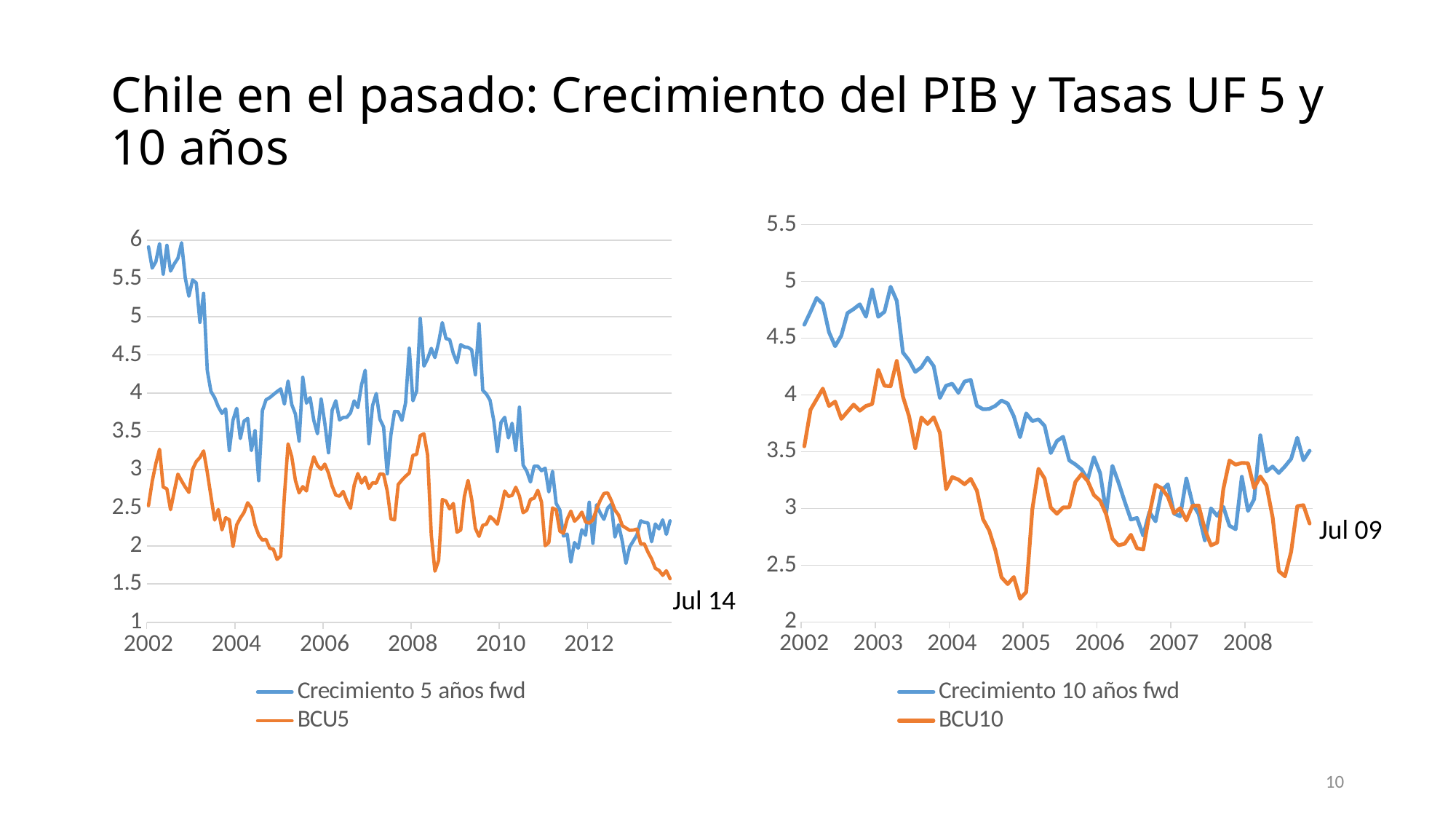
What kind of chart is the left chart on the slide? line chart In the right chart, is the lowest value of BCU10 around early 2005 greater or less than 2.5? less In the left chart, does Crecimiento 5 años fwd overall rise or fall from 2002 to the end of the series? fall How many series does the legend of the right chart list? 2 What date label is annotated at the end of the series in the right chart? Jul 09 What are the two legend entries of the left chart? Crecimiento 5 años fwd and BCU5 In the right chart, is the peak value of Crecimiento 10 años fwd in 2003 greater or less than 4.5? greater In the left chart, is the value of BCU5 at the end of the series (Jul 14) greater or less than 2? less In the right chart, does Crecimiento 10 años fwd overall rise or fall from 2002 to 2008? fall In the right chart, which series is higher at the start of 2002, Crecimiento 10 años fwd or BCU10? Crecimiento 10 años fwd